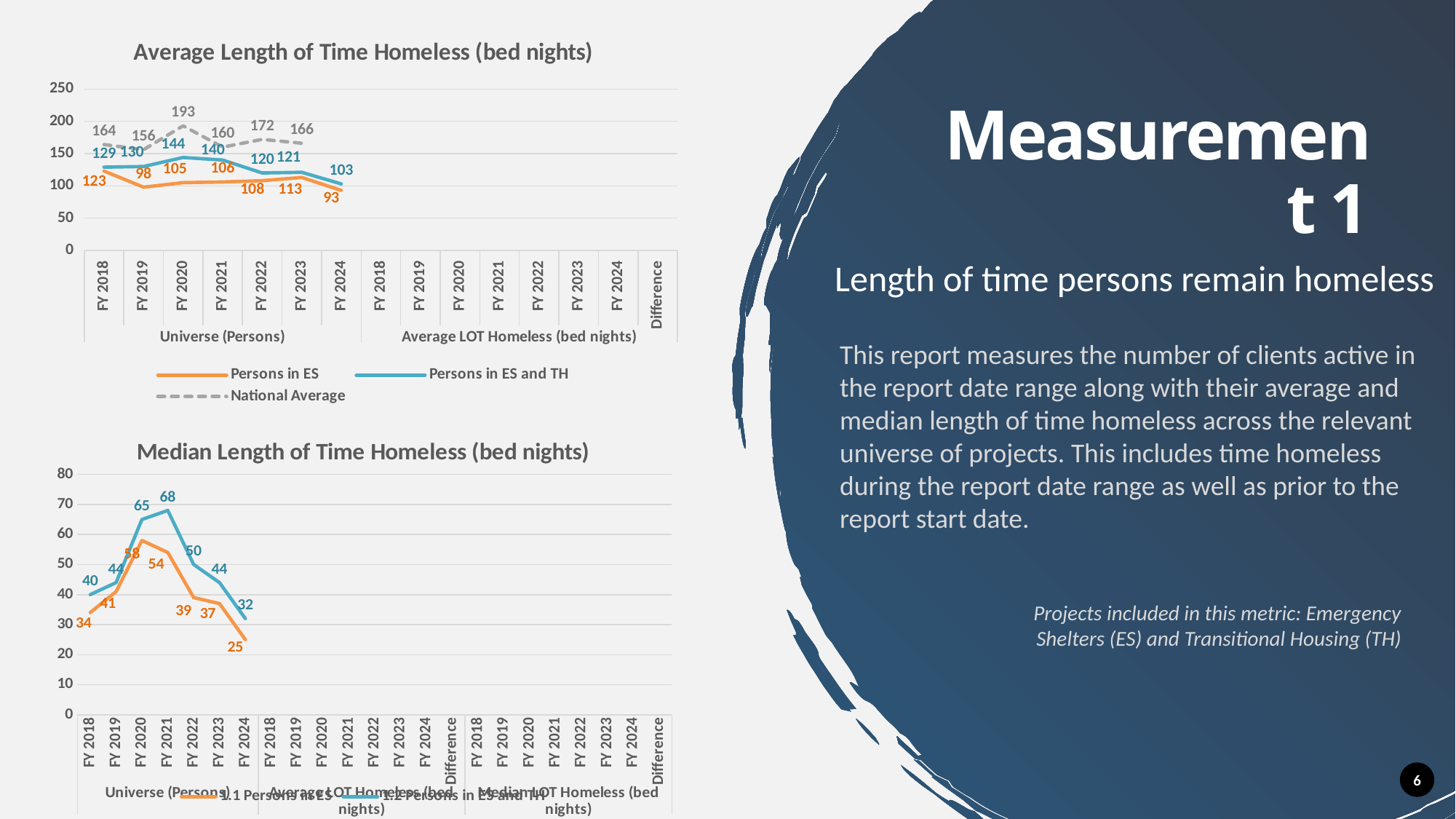
In the Average Length of Time Homeless (bed nights) chart, what is the value for Persons in ES in FY 2024? 93 In the Median Length of Time Homeless (bed nights) chart, what is the difference between 1.2 Persons in ES and TH and 1.1 Persons in ES in FY 2024? 7 In the Average Length of Time Homeless (bed nights) chart, what is the value for Persons in ES and TH in FY 2021? 140 In the Median Length of Time Homeless (bed nights) chart, do the 1.1 Persons in ES values rise or fall from FY 2021 to FY 2024? Fall How many series does the legend of the Average Length of Time Homeless (bed nights) chart list? 3 In the Median Length of Time Homeless (bed nights) chart, which is larger in FY 2022: 1.1 Persons in ES or 1.2 Persons in ES and TH? 1.2 Persons in ES and TH What kind of chart is the Median Length of Time Homeless (bed nights) chart? Line chart In the Median Length of Time Homeless (bed nights) chart, what is the value for 1.2 Persons in ES and TH in FY 2021? 68 In the Median Length of Time Homeless (bed nights) chart, in which fiscal year is the 1.1 Persons in ES value highest? FY 2020 In the Average Length of Time Homeless (bed nights) chart, in which fiscal year is the Persons in ES value lowest? FY 2024 In the Average Length of Time Homeless (bed nights) chart, what is the difference between the National Average and Persons in ES and TH in FY 2020? 49 In the Average Length of Time Homeless (bed nights) chart, what is the National Average value in FY 2020? 193